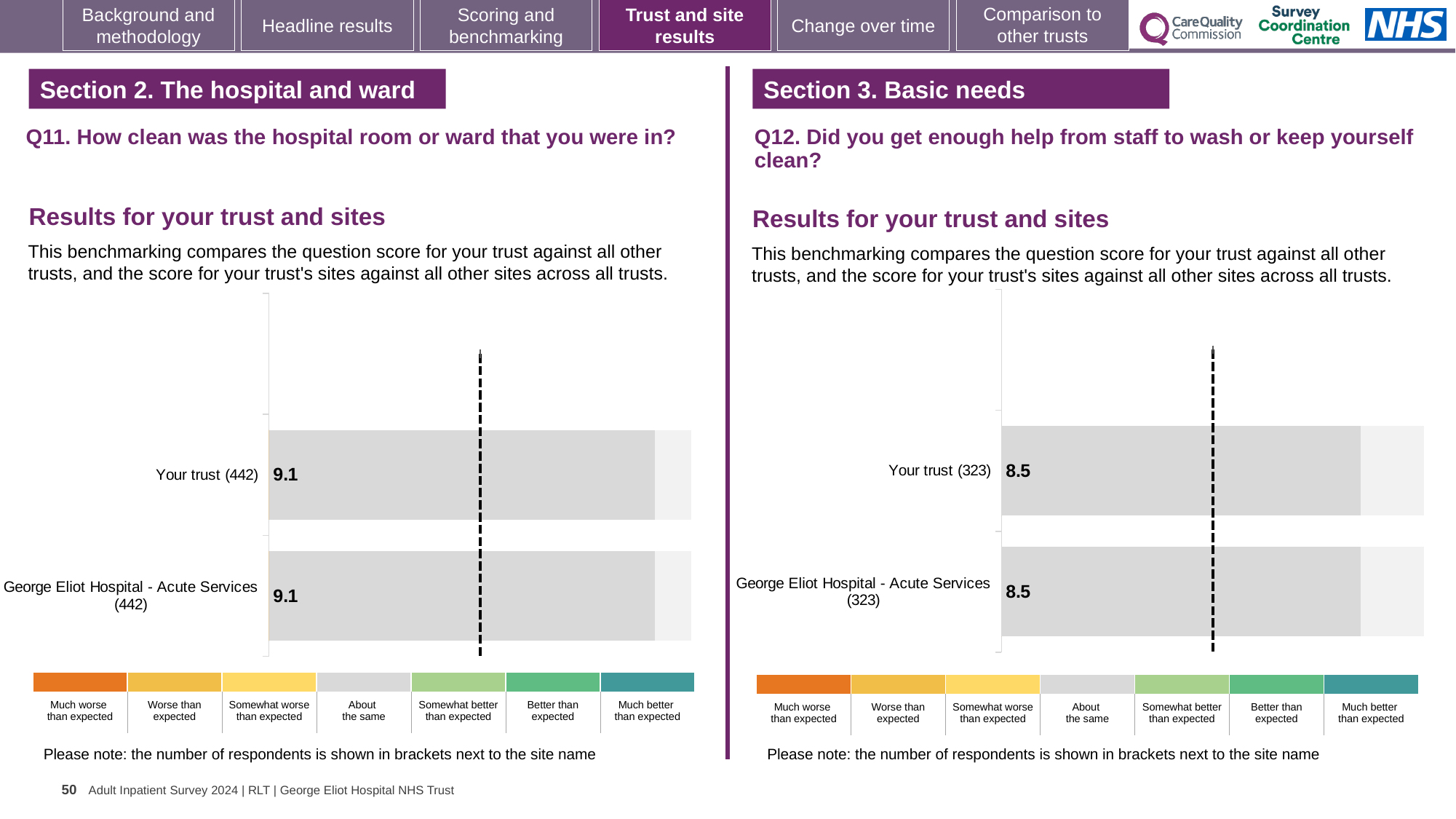
In the Q12 chart on the right, what is the difference between the score for Your trust and the score for George Eliot Hospital - Acute Services? 0 In the Q11 chart on the left, what is the difference between the score for Your trust and the score for George Eliot Hospital - Acute Services? 0 What type of chart is used for the Q11 results on the left? Bar chart How many bars are plotted in the Q11 chart on the left? 2 How many bars are plotted in the Q12 chart on the right? 2 In the Q12 chart on the right, how many respondents are shown in brackets for George Eliot Hospital - Acute Services? 323 In the Q11 chart on the left, how many respondents are shown in brackets for Your trust? 442 In the Q11 chart on the left, what is the score for George Eliot Hospital - Acute Services? 9.1 In the Q12 chart on the right, what is the score for George Eliot Hospital - Acute Services? 8.5 In the Q11 chart on the left, what is the score for Your trust? 9.1 In the Q12 chart on the right, what is the score for Your trust? 8.5 Is the Your trust score in the Q11 chart on the left larger than the Your trust score in the Q12 chart on the right? Yes